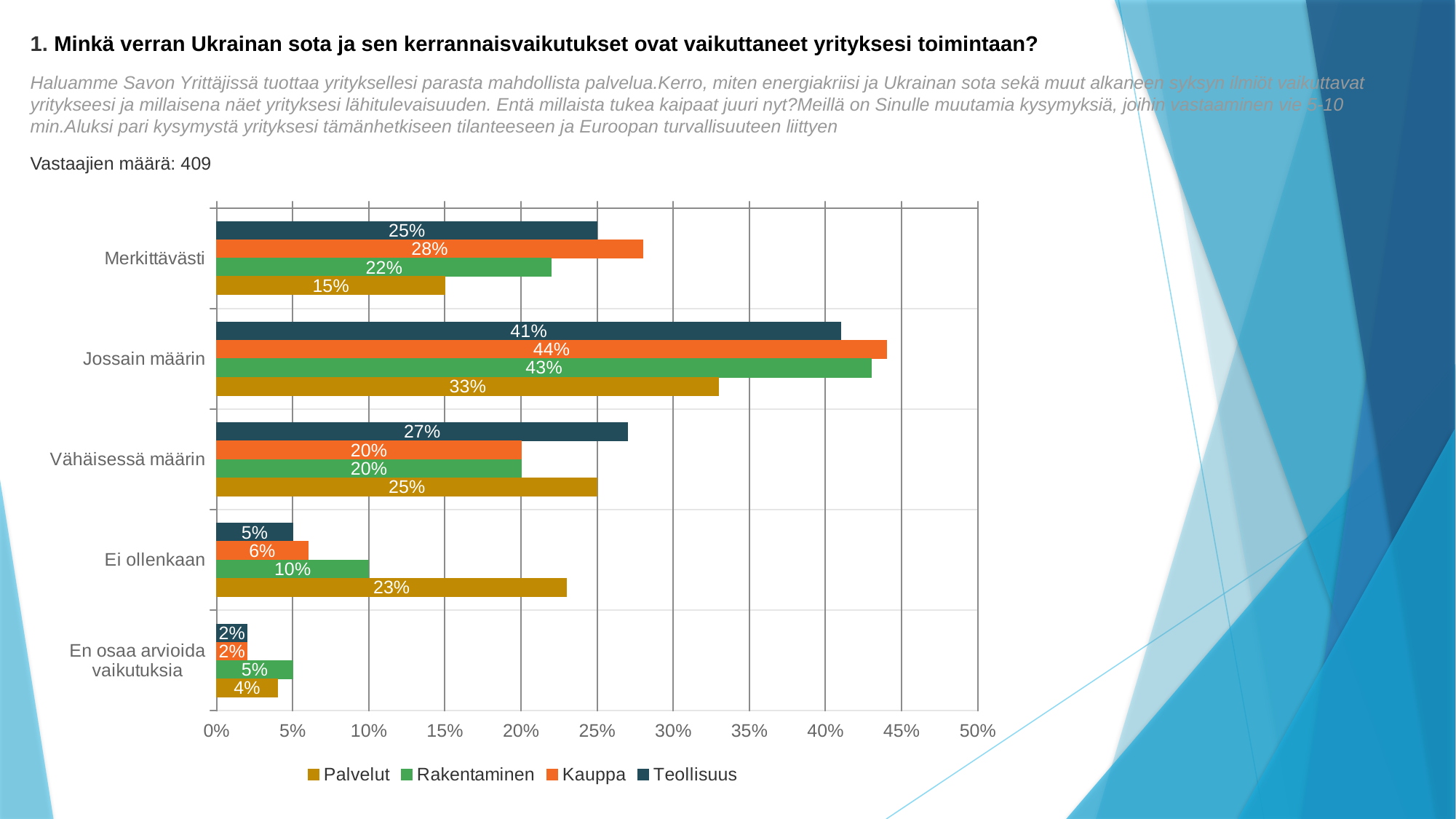
Which series is shown in orange in the legend? Kauppa What is the value for Palvelut in the category Ei ollenkaan? 23% Which series has the lowest value in the category Ei ollenkaan? Teollisuus How many categories are shown on the vertical axis of the chart? 5 What is the value for Kauppa in the category Jossain määrin? 44% Which series has the highest value in the category Merkittävästi? Kauppa In the category Ei ollenkaan, which is larger: the value for Rakentaminen or the value for Kauppa? Rakentaminen Which category has the highest value for Palvelut? Jossain määrin What is the value for Teollisuus in the category Vähäisessä määrin? 27% What kind of chart is shown on the slide? bar chart What is the difference between the Palvelut and Teollisuus values in the category Merkittävästi? 10% How many series does the legend list? 4